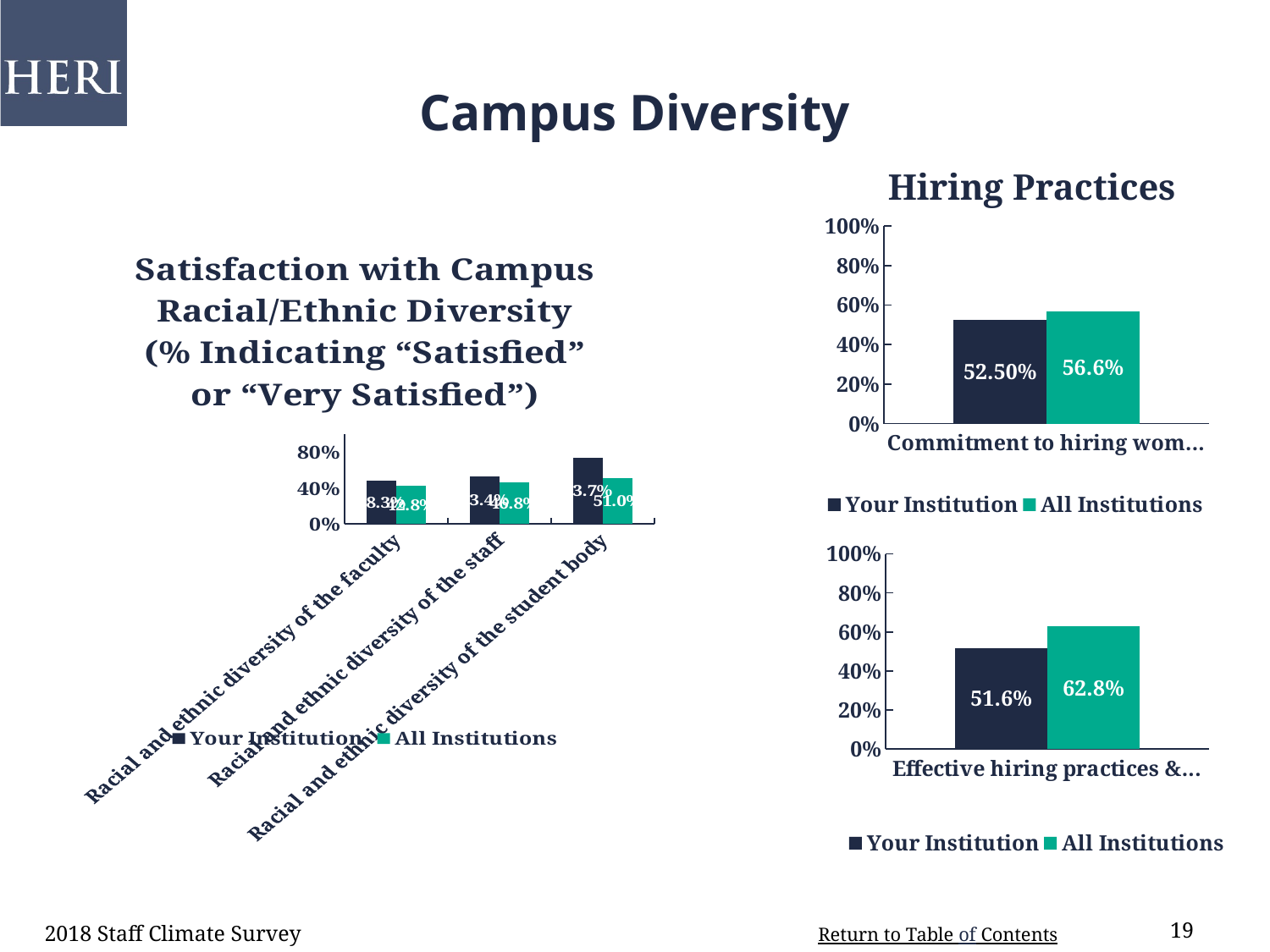
In the bottom-right chart for 'Effective hiring practices &...', what is the difference between All Institutions and Your Institution? 11.2 percentage points In the bottom-right chart for 'Effective hiring practices &...', what is the value for Your Institution? 51.6% In the Hiring Practices chart for 'Commitment to hiring wom...', which series has the larger value, Your Institution or All Institutions? All Institutions In the bottom-right chart for 'Effective hiring practices &...', is the value for All Institutions greater or less than 60%? greater How many categories are shown on the x axis of the 'Satisfaction with Campus Racial/Ethnic Diversity' chart? 3 How many series does the legend of the Hiring Practices chart list? 2 In the bottom-right chart for 'Effective hiring practices &...', what is the value for All Institutions? 62.8% In the 'Satisfaction with Campus Racial/Ethnic Diversity' chart, is the Your Institution value for 'Racial and ethnic diversity of the student body' greater or less than 40%? greater In the Hiring Practices chart for 'Commitment to hiring wom...', what is the value for All Institutions? 56.6% What kind of chart is the Hiring Practices chart? Bar chart In the Hiring Practices chart for 'Commitment to hiring wom...', what is the value for Your Institution? 52.50% In the 'Satisfaction with Campus Racial/Ethnic Diversity' chart, which colour represents All Institutions? Green